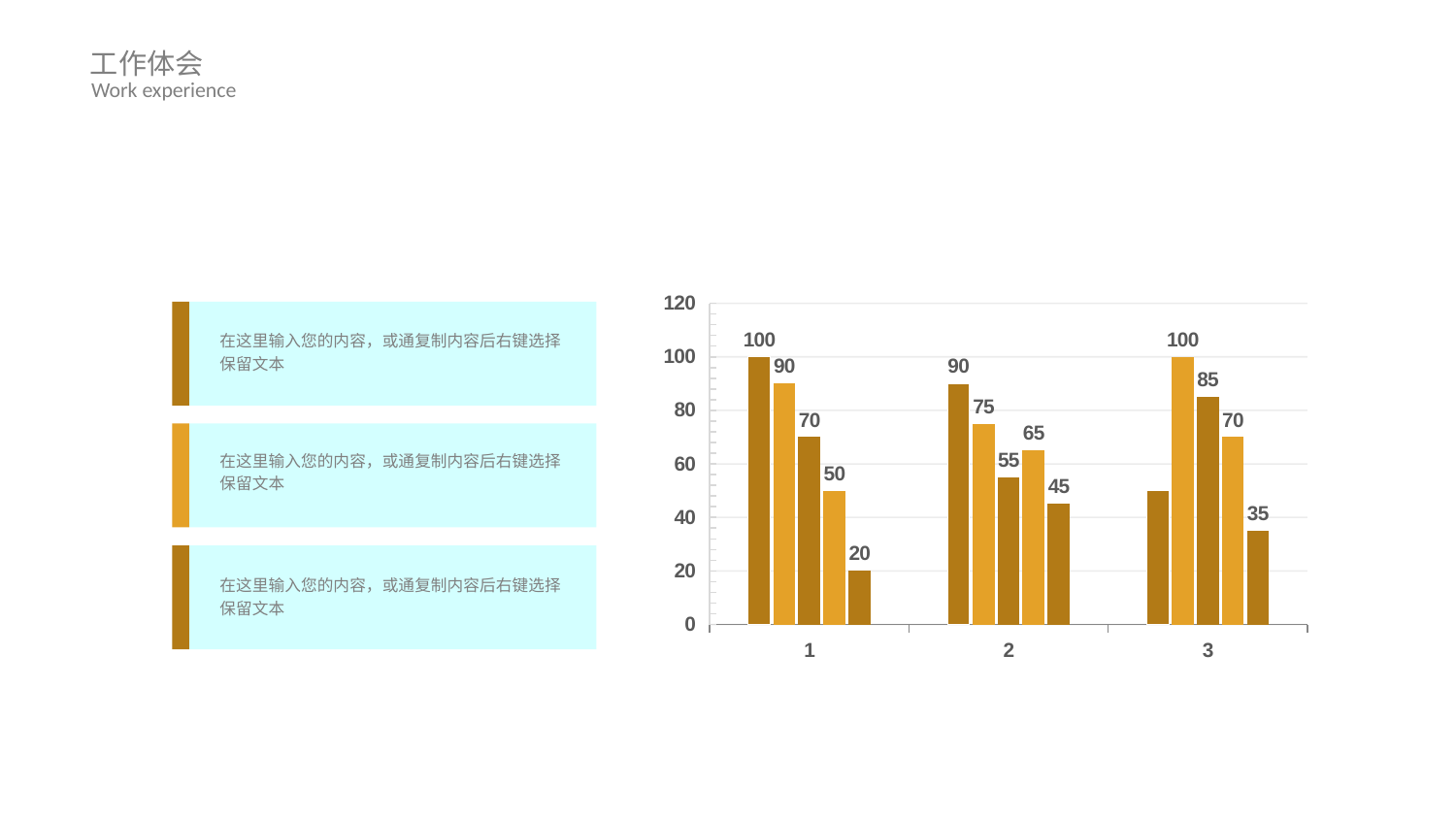
What is the value of the second bar in category 2? 75 What is the difference between the tallest bar (100) and the last bar (35) in category 3? 65 What is the highest value shown on the chart's vertical axis? 120 How many categories are shown on the x axis of the chart? 3 Is the value of the first bar in category 3 greater or less than 60? less What is the value of the shortest bar in category 1? 20 How many bars are plotted for each category in the chart? 5 What is the difference between the tallest and shortest bars in category 1? 80 What is the value of the last bar in category 3? 35 In category 2, is the third bar or the fourth bar taller? the fourth bar What is the value of the tallest bar in category 1? 100 What kind of chart is shown on the slide? bar chart